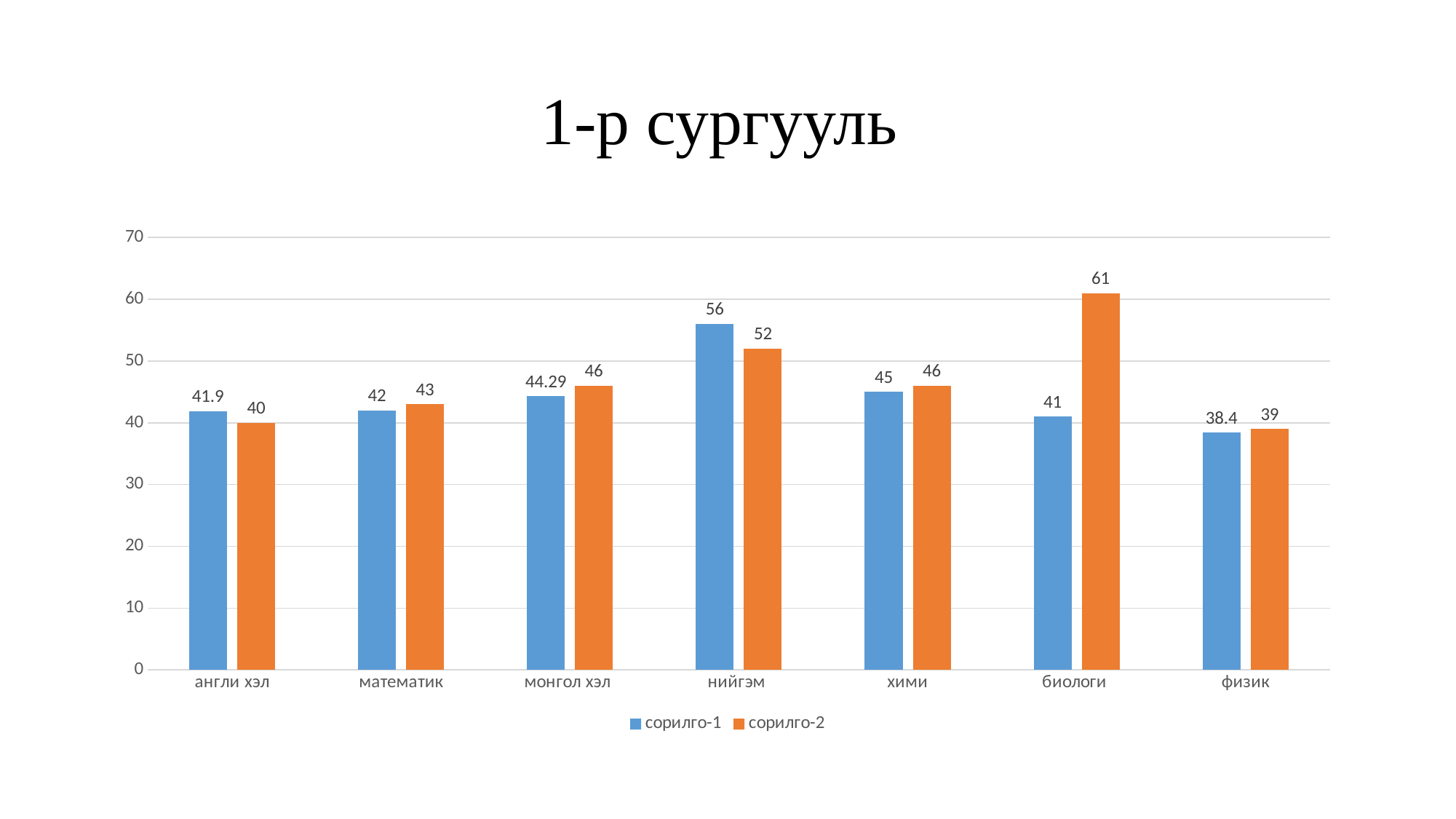
Which is larger in хими, сорилго-1 or сорилго-2? сорилго-2 What is the value for сорилго-1 in монгол хэл? 44.29 What is the value for сорилго-1 in англи хэл? 41.9 What is the difference between сорилго-2 and сорилго-1 in биологи? 20 Which category has the lowest сорилго-1 value? физик How many series does the legend list? 2 How many categories are shown on the x axis? 7 What is the value for сорилго-2 in биологи? 61 What kind of chart is shown on the slide? bar chart What is the difference between сорилго-1 and сорилго-2 in нийгэм? 4 What is the title of the slide? 1-р сургууль Which category has the highest сорилго-2 value? биологи